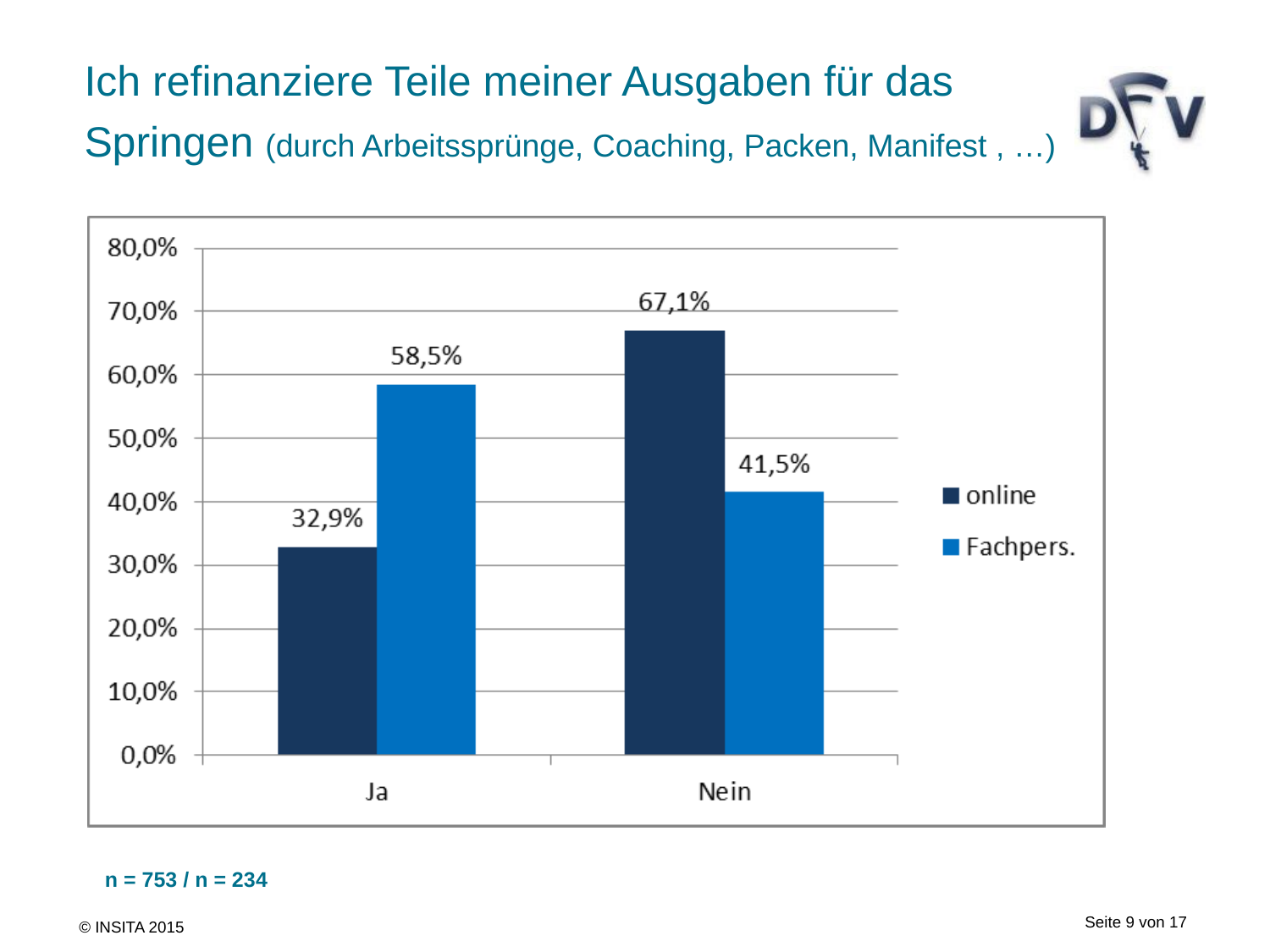
How many categories are shown on the x axis? 2 What kind of chart is shown on the slide? bar chart What is the value for 'online' in the 'Ja' category? 32,9% What are the two series names listed in the legend? online and Fachpers. What is the difference between the 'Fachpers.' and 'online' values in the 'Ja' category? 25,6% What is the value for 'online' in the 'Nein' category? 67,1% How many series does the legend list? 2 In the 'Nein' category, which series has the larger value, 'online' or 'Fachpers.'? online What is the value for 'Fachpers.' in the 'Nein' category? 41,5% What is the value for 'Fachpers.' in the 'Ja' category? 58,5% Which bar has the highest value in the chart? online, Nein Which bar has the lowest value in the chart? online, Ja